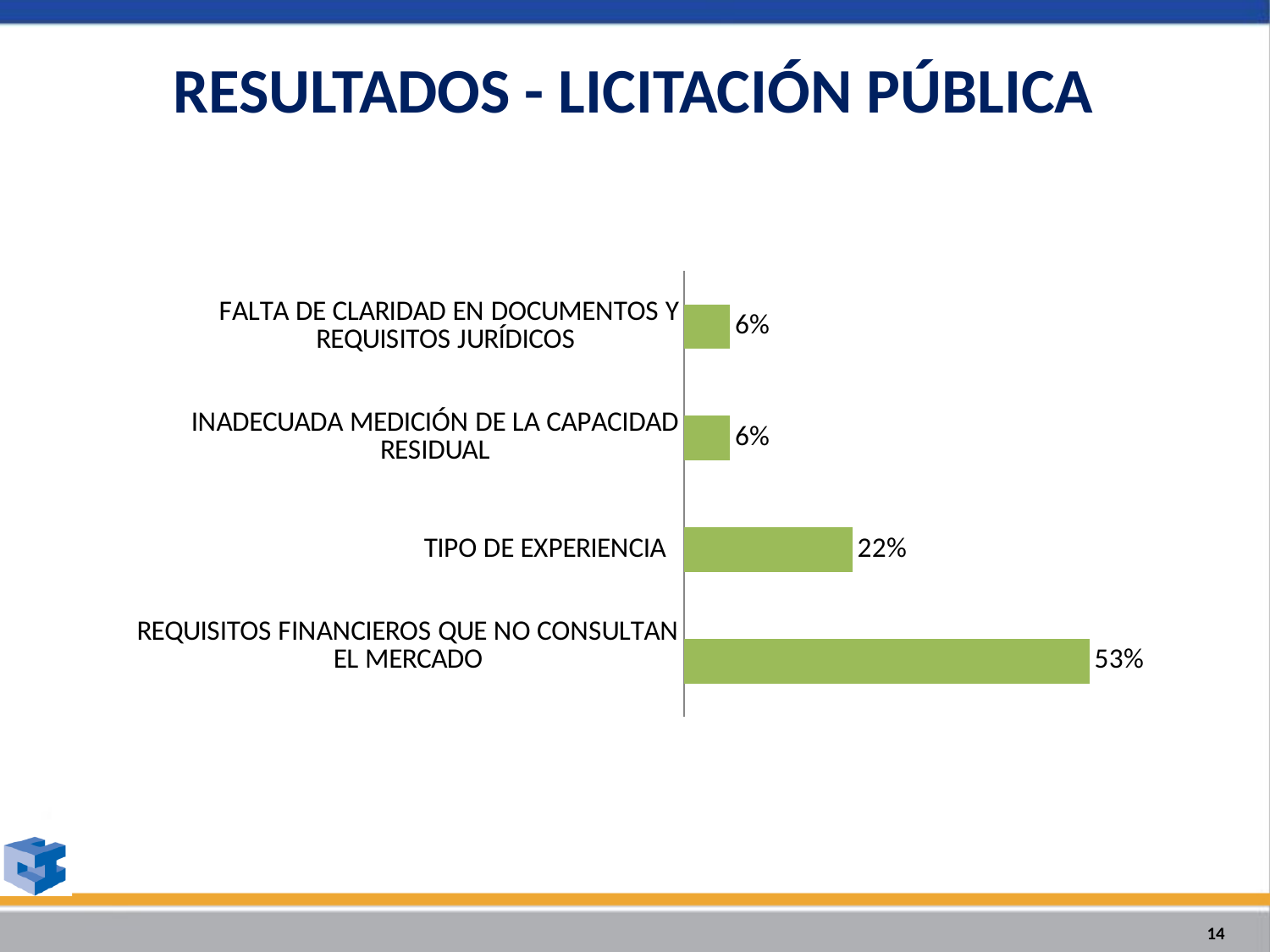
Which category has the highest value? REQUISITOS FINANCIEROS QUE NO CONSULTAN EL MERCADO What is the value for FALTA DE CLARIDAD EN DOCUMENTOS Y REQUISITOS JURÍDICOS? 6% What is the difference between the values for TIPO DE EXPERIENCIA and INADECUADA MEDICIÓN DE LA CAPACIDAD RESIDUAL? 16% What kind of chart is shown on the slide? Bar chart What is the title of the slide containing the chart? RESULTADOS - LICITACIÓN PÚBLICA What is the value for TIPO DE EXPERIENCIA? 22% What is the value for INADECUADA MEDICIÓN DE LA CAPACIDAD RESIDUAL? 6% Which is larger, the value for TIPO DE EXPERIENCIA or the value for FALTA DE CLARIDAD EN DOCUMENTOS Y REQUISITOS JURÍDICOS? TIPO DE EXPERIENCIA What is the difference between the values for REQUISITOS FINANCIEROS QUE NO CONSULTAN EL MERCADO and TIPO DE EXPERIENCIA? 31% How many categories are shown in the chart? 4 How many categories have a value of 6%? 2 What is the value for REQUISITOS FINANCIEROS QUE NO CONSULTAN EL MERCADO? 53%